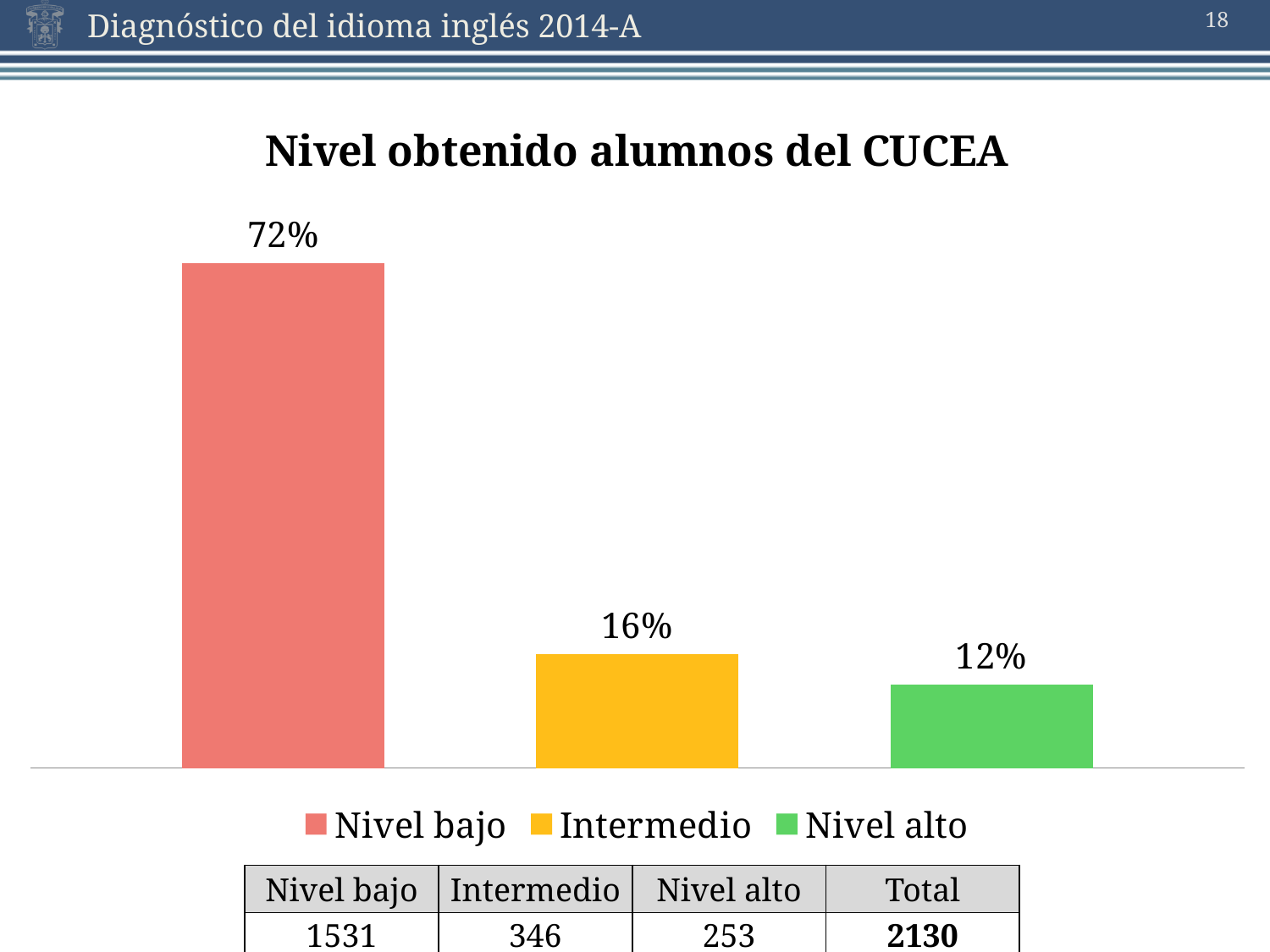
How many bars are shown in the chart? 3 What is the title of the chart? Nivel obtenido alumnos del CUCEA Which is larger, the percentage for Intermedio or for Nivel alto? Intermedio How many entries does the legend list? 3 What percentage is shown for Intermedio? 16% What percentage is shown for Nivel alto? 12% What type of chart is shown on the slide? Bar chart What is the difference in percentage points between Nivel bajo and Intermedio? 56 What percentage is shown for Nivel bajo? 72% Which level has the highest percentage? Nivel bajo Which level has the lowest percentage? Nivel alto What is the difference in percentage points between Intermedio and Nivel alto? 4